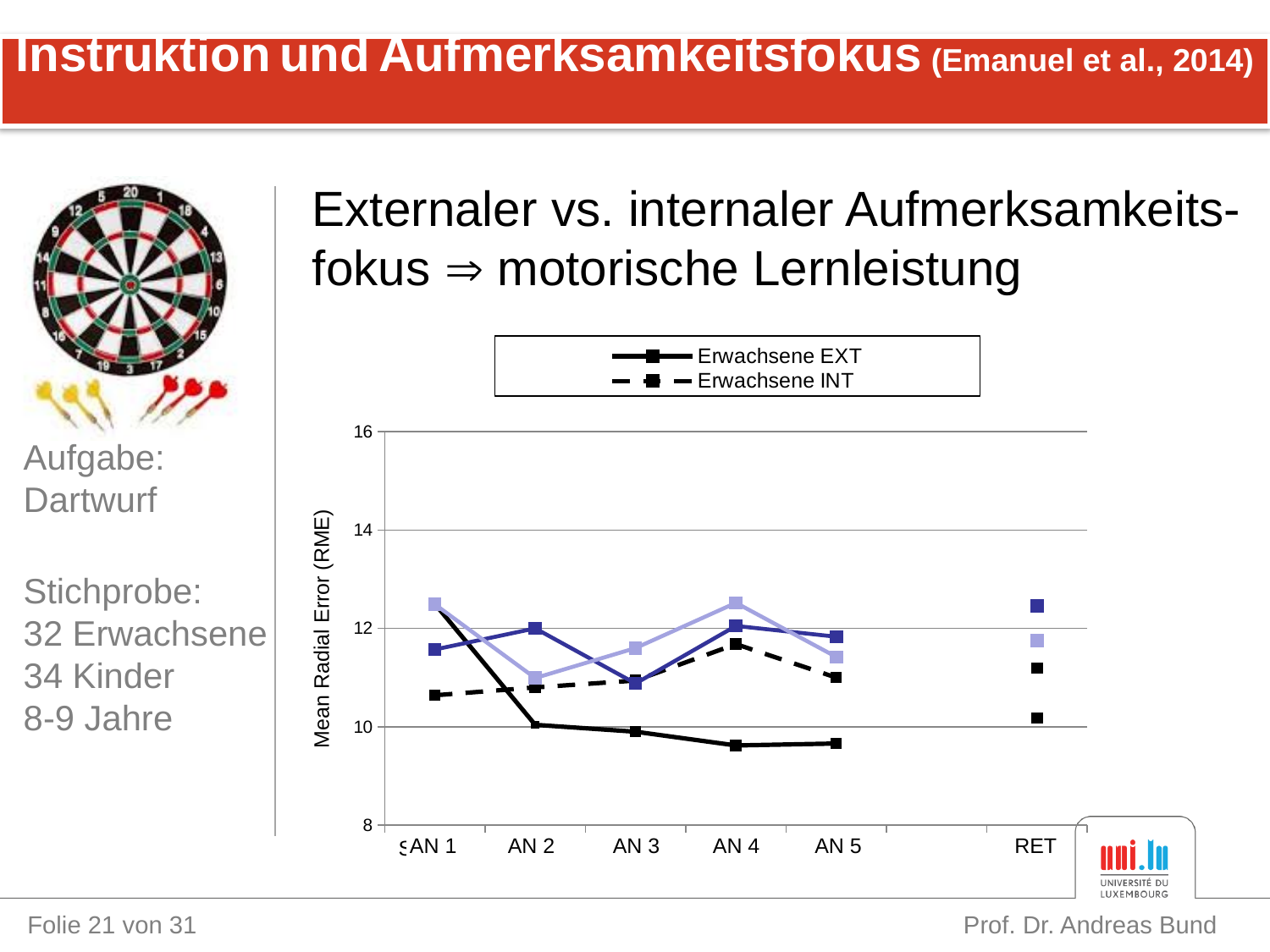
Is the value for Erwachsene EXT at AN 1 greater or less than 12? greater How many categories are shown on the x axis of the chart? 6 Which two series are named in the chart legend? Erwachsene EXT and Erwachsene INT What is the label of the y axis of the chart? Mean Radial Error (RME) Is the value for Erwachsene INT at AN 1 greater or less than 12? less What kind of chart is shown on the slide? line chart How many series does the chart legend list? 2 At AN 5, which series has the higher value, Erwachsene EXT or Erwachsene INT? Erwachsene INT At which x-axis category does the Erwachsene EXT series reach its highest value? AN 1 Is the value for Erwachsene EXT at AN 4 greater or less than 10? less Does the Erwachsene INT series rise or fall from AN 1 to AN 4? rise Does the Erwachsene EXT series rise or fall from AN 1 to AN 5? fall